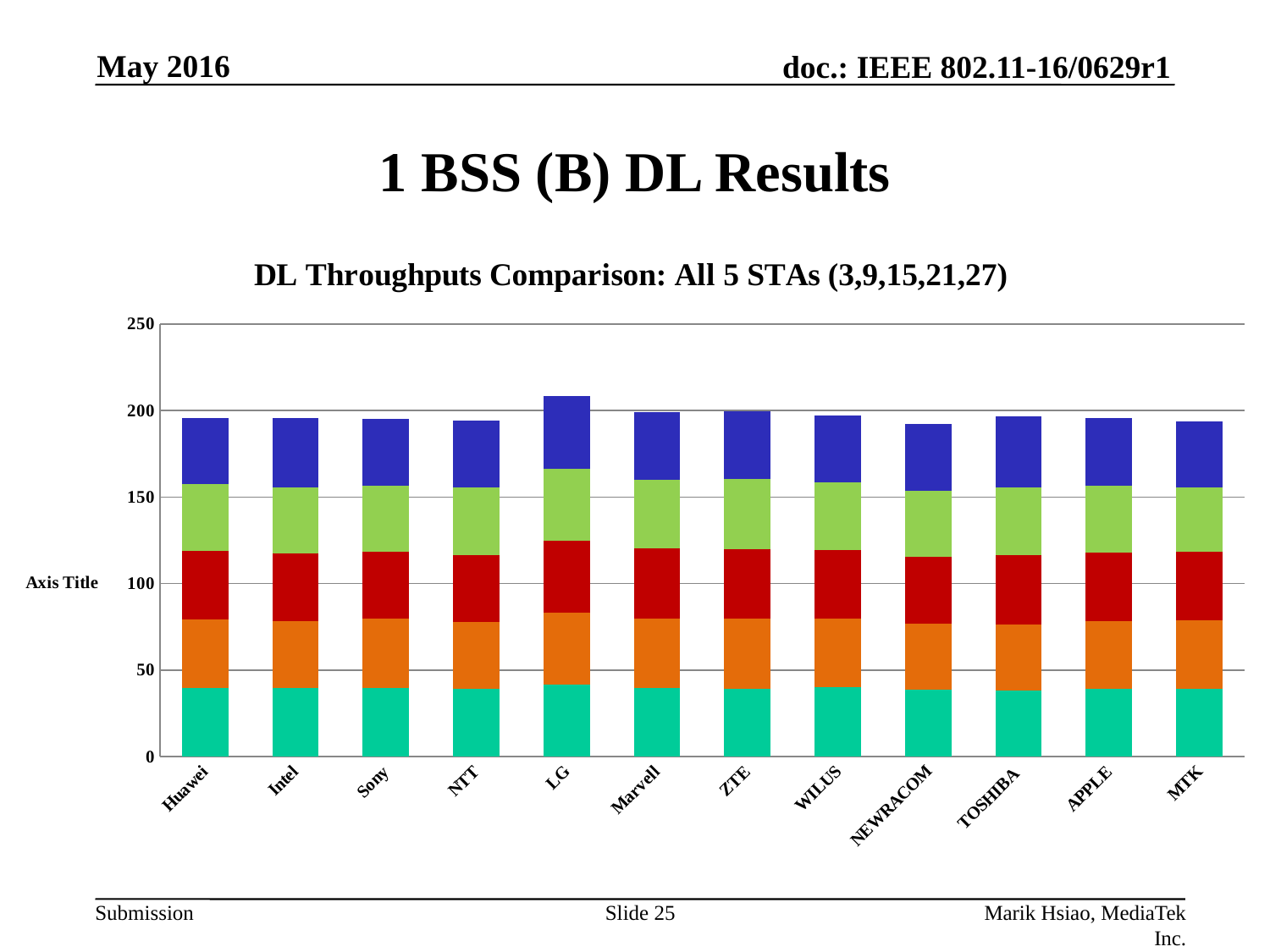
How many categories (companies) are shown on the x axis of the chart? 12 What is the title of the chart? DL Throughputs Comparison: All 5 STAs (3,9,15,21,27) What kind of chart is shown on the slide? stacked bar chart Is the total stacked value for LG greater or less than 200? greater What is the label shown on the vertical axis of the chart? Axis Title Which has the taller stacked bar, LG or NEWRACOM? LG Is the bottom (teal) segment of the Huawei bar greater or less than 50? less Which category has the tallest stacked bar in the chart? LG Is the total stacked value for NEWRACOM greater or less than 200? less Which has the taller stacked bar, LG or Huawei? LG